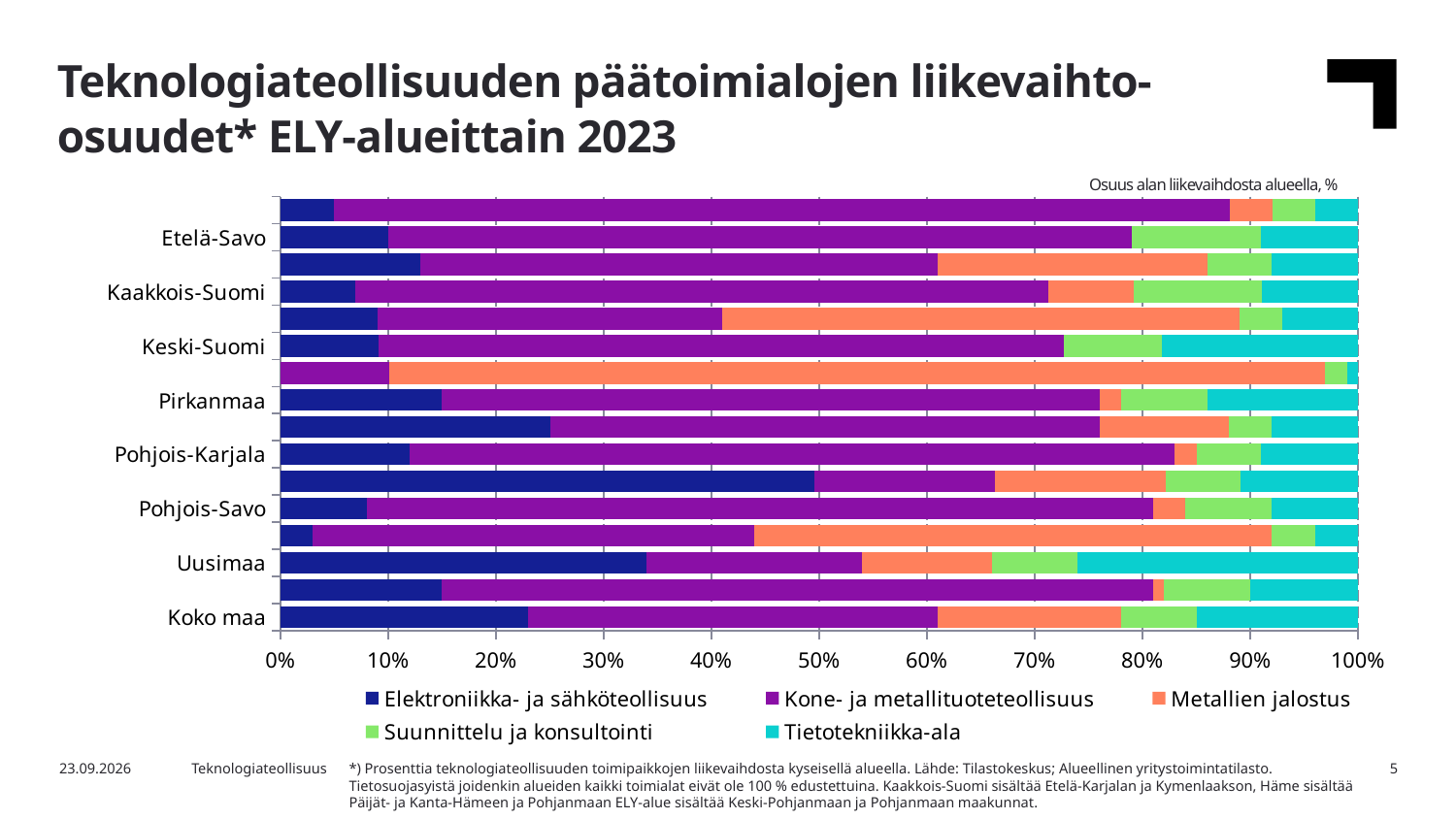
Is the Elektroniikka- ja sähköteollisuus share for Pohjois-Savo greater or less than 10%? less What kind of chart is shown on the slide? Stacked bar chart Which has the larger Elektroniikka- ja sähköteollisuus share, Uusimaa or Koko maa? Uusimaa Which has the larger Elektroniikka- ja sähköteollisuus share, Uusimaa or Pohjois-Savo? Uusimaa Which series is listed first in the legend? Elektroniikka- ja sähköteollisuus Is the Tietotekniikka-ala share for Uusimaa greater or less than 20%? greater What is the highest value shown on the horizontal axis? 100% Is the Elektroniikka- ja sähköteollisuus share for Koko maa greater or less than 20%? greater How many series does the legend list? 5